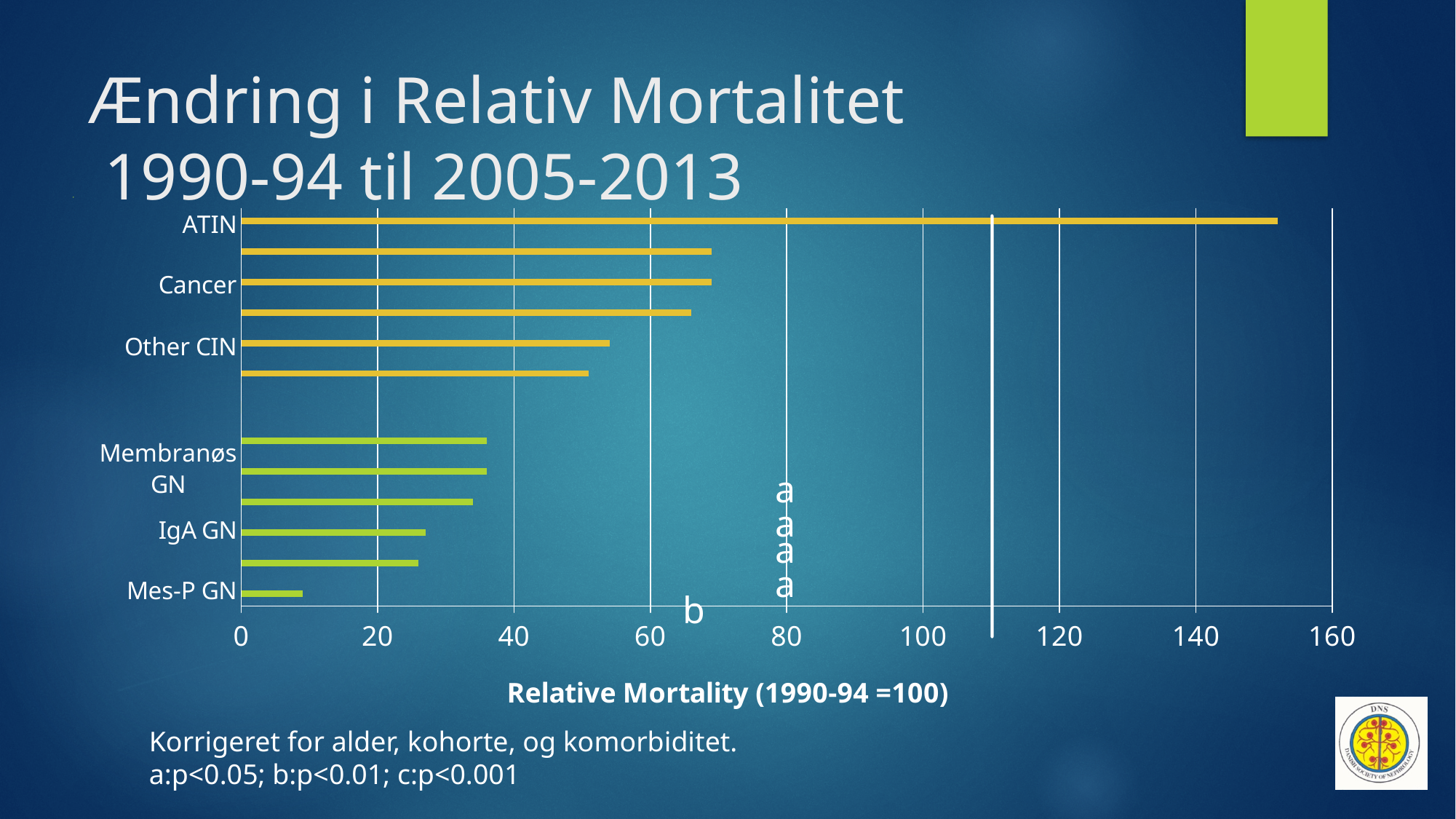
Is the value for IgA GN greater or less than 40? less Is the value for Membranøs GN greater or less than 20? greater Is the value for Cancer greater or less than 80? less Which is larger, the value for Cancer or the value for IgA GN? Cancer Which category has the highest relative mortality? ATIN What is the title of the horizontal axis? Relative Mortality (1990-94 =100) What kind of chart is shown on the slide? bar chart Which is larger, the value for Other CIN or the value for ATIN? ATIN Which category has the lowest relative mortality? Mes-P GN